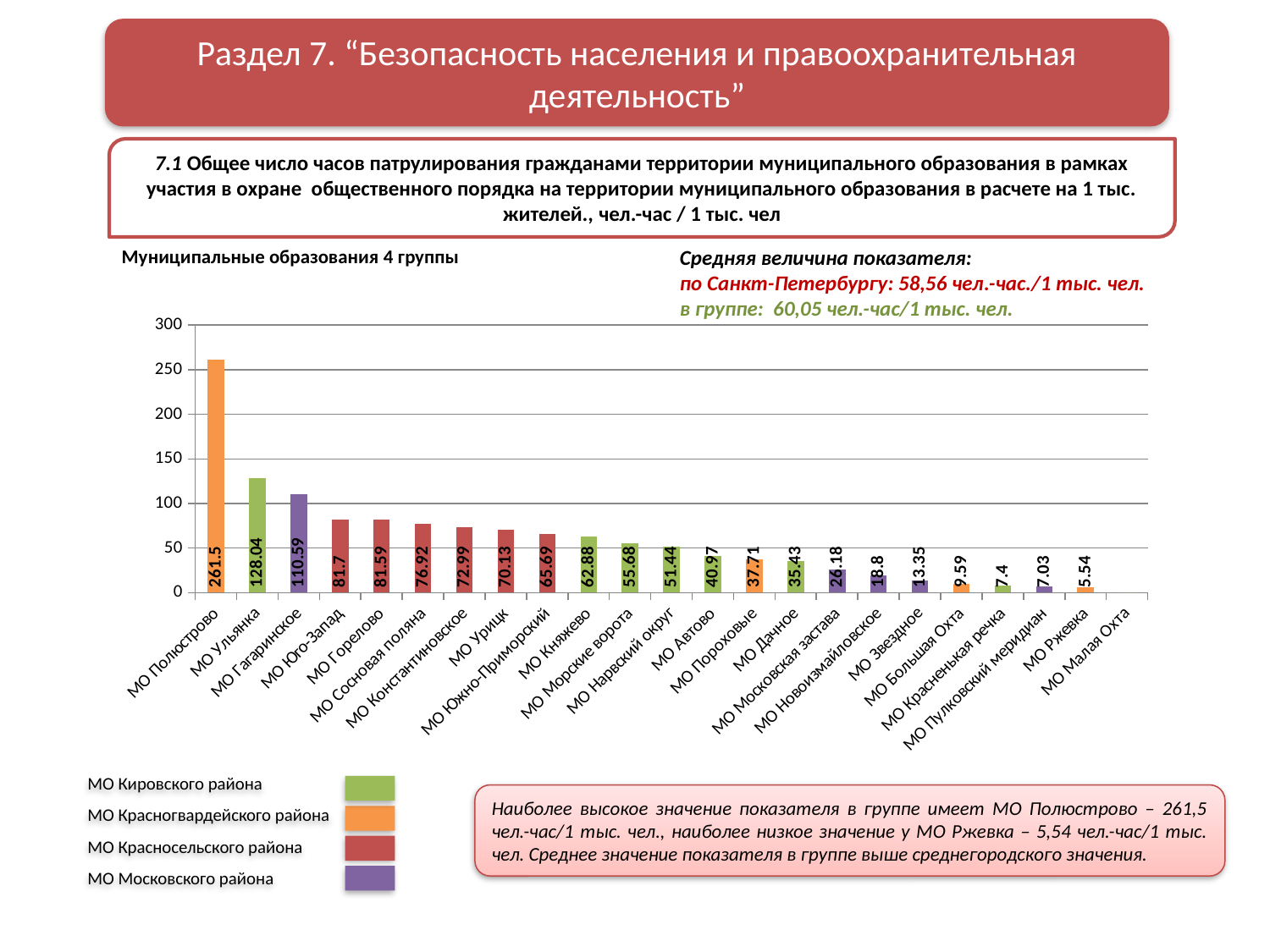
How many entries does the legend list? 4 What is the value for МО Московская застава? 26.18 What kind of chart is shown on the slide? bar chart Which is larger, the value for МО Княжево or the value for МО Морские ворота? МО Княжево What is the value for МО Урицк? 70.13 Which category has the lowest labelled value? МО Ржевка How many categories are labelled on the x axis? 23 What is the difference between the values for МО Полюстрово and МО Ульянка? 133.46 Is the value for МО Гагаринское greater or less than 100? greater Which category has the highest value? МО Полюстрово Do the values rise or fall from left to right along the x axis? fall What is the value for МО Ульянка? 128.04